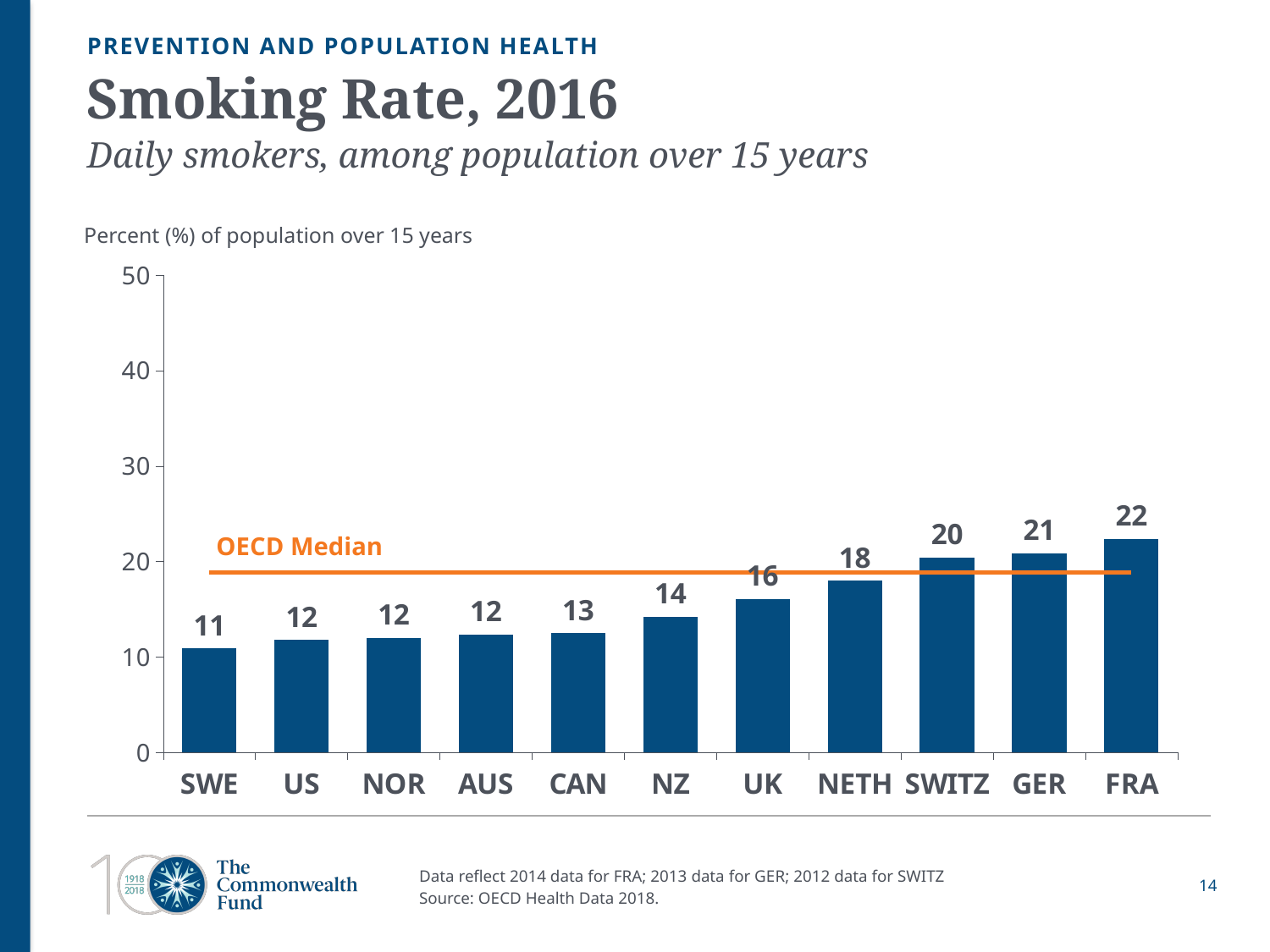
What is the smoking rate for SWITZ? 20 What kind of chart is shown on the slide? Bar chart Which has a higher smoking rate, GER or NZ? GER What is the difference between the smoking rates of NETH and CAN? 5 Is the value for FRA greater or less than 30? less Which country has the highest smoking rate? FRA What is the difference between the smoking rates of FRA and SWE? 11 Which country has the lowest smoking rate? SWE Do the values rise or fall from left to right along the x axis? Rise How many countries are shown in the chart? 11 What does the orange horizontal line on the chart represent? OECD Median What is the smoking rate for the UK? 16